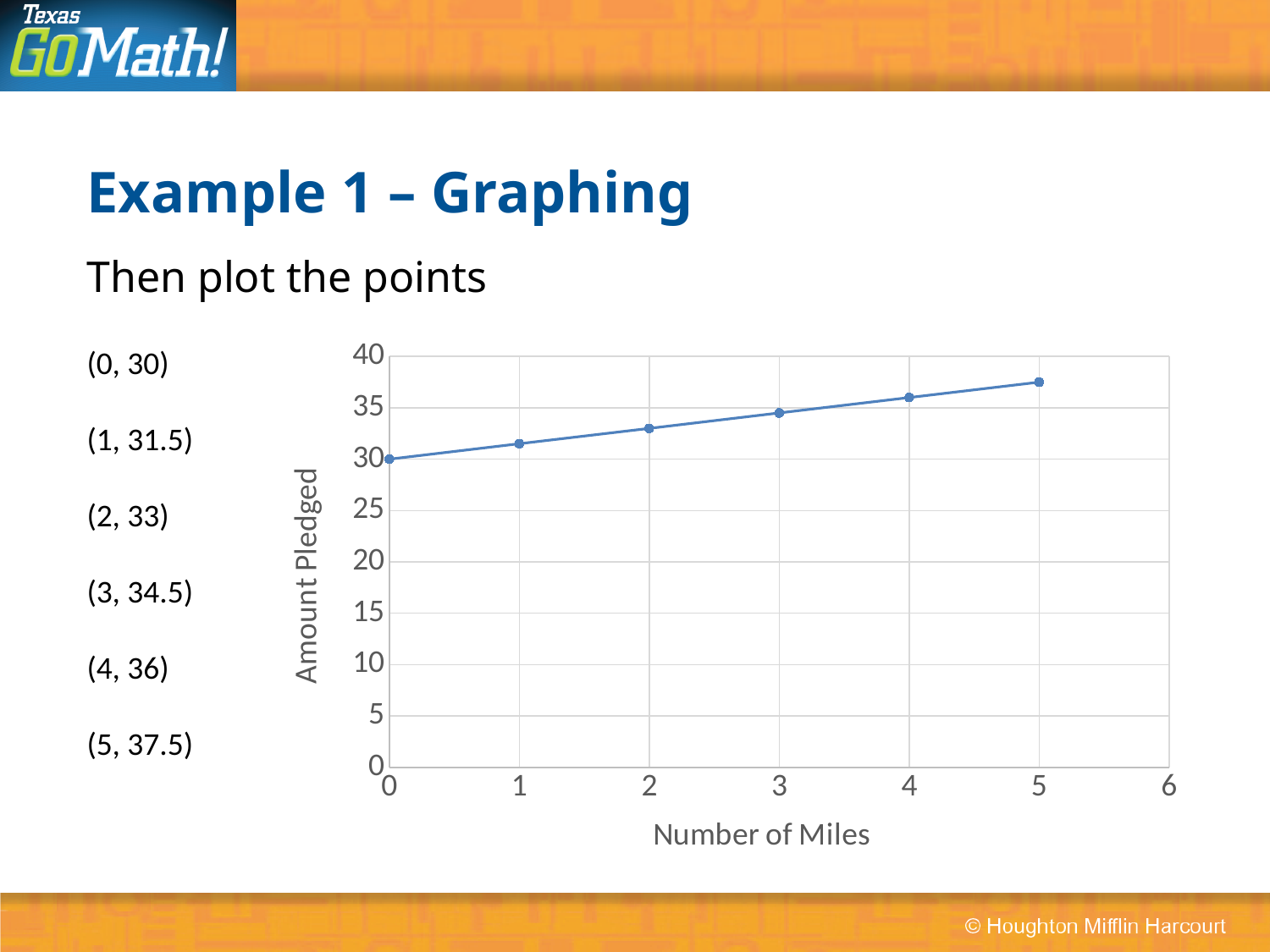
Which has a larger amount pledged, 4 miles or 2 miles? 4 miles What is the amount pledged for 0 miles? 30 What is the amount pledged for 5 miles? 37.5 Does the amount pledged rise or fall as the number of miles increases? rise At which number of miles is the amount pledged highest? 5 At which number of miles is the amount pledged lowest? 0 How many points are plotted on the chart? 6 What is the difference between the amount pledged at 2 miles and at 1 mile? 1.5 Is the amount pledged at 5 miles greater or less than 35? greater What is the amount pledged for 3 miles? 34.5 What is the difference between the amount pledged at 5 miles and at 0 miles? 7.5 What kind of chart is shown on the slide? line chart